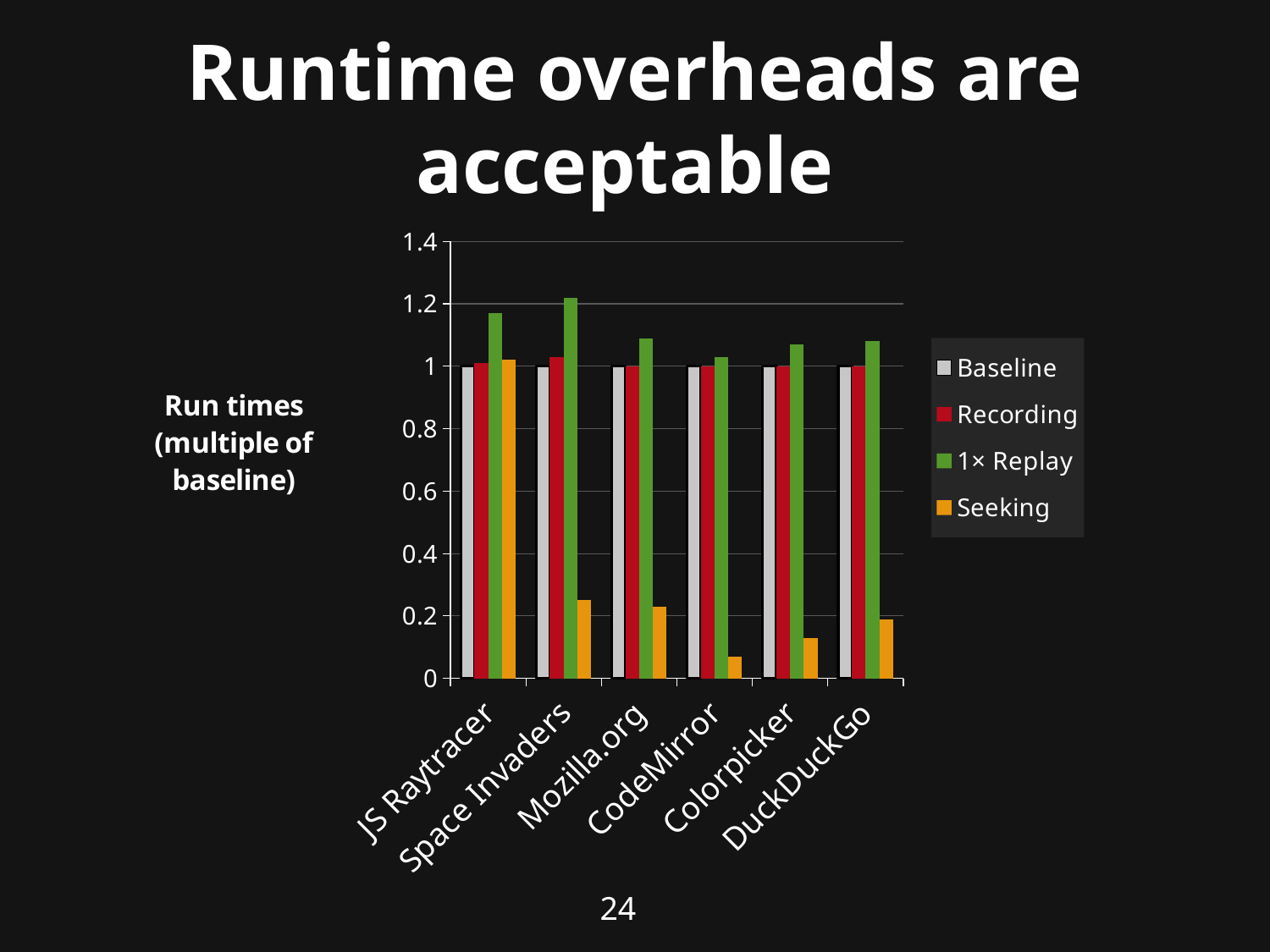
Is the Seeking value for CodeMirror greater or less than 0.2? less What label is given to the vertical axis of the chart? Run times (multiple of baseline) What is the Baseline value for CodeMirror? 1 Is the 1× Replay value for JS Raytracer greater or less than 1? greater How many categories are shown on the x axis of the chart? 6 Which category has the highest 1× Replay value? Space Invaders Which category has the lowest Seeking value? CodeMirror How many series does the chart's legend list? 4 Which is larger for Mozilla.org, the 1× Replay value or the Seeking value? 1× Replay Which category has the highest Seeking value? JS Raytracer Is the Seeking value for Space Invaders greater or less than 0.2? greater What kind of chart is shown on the slide? bar chart